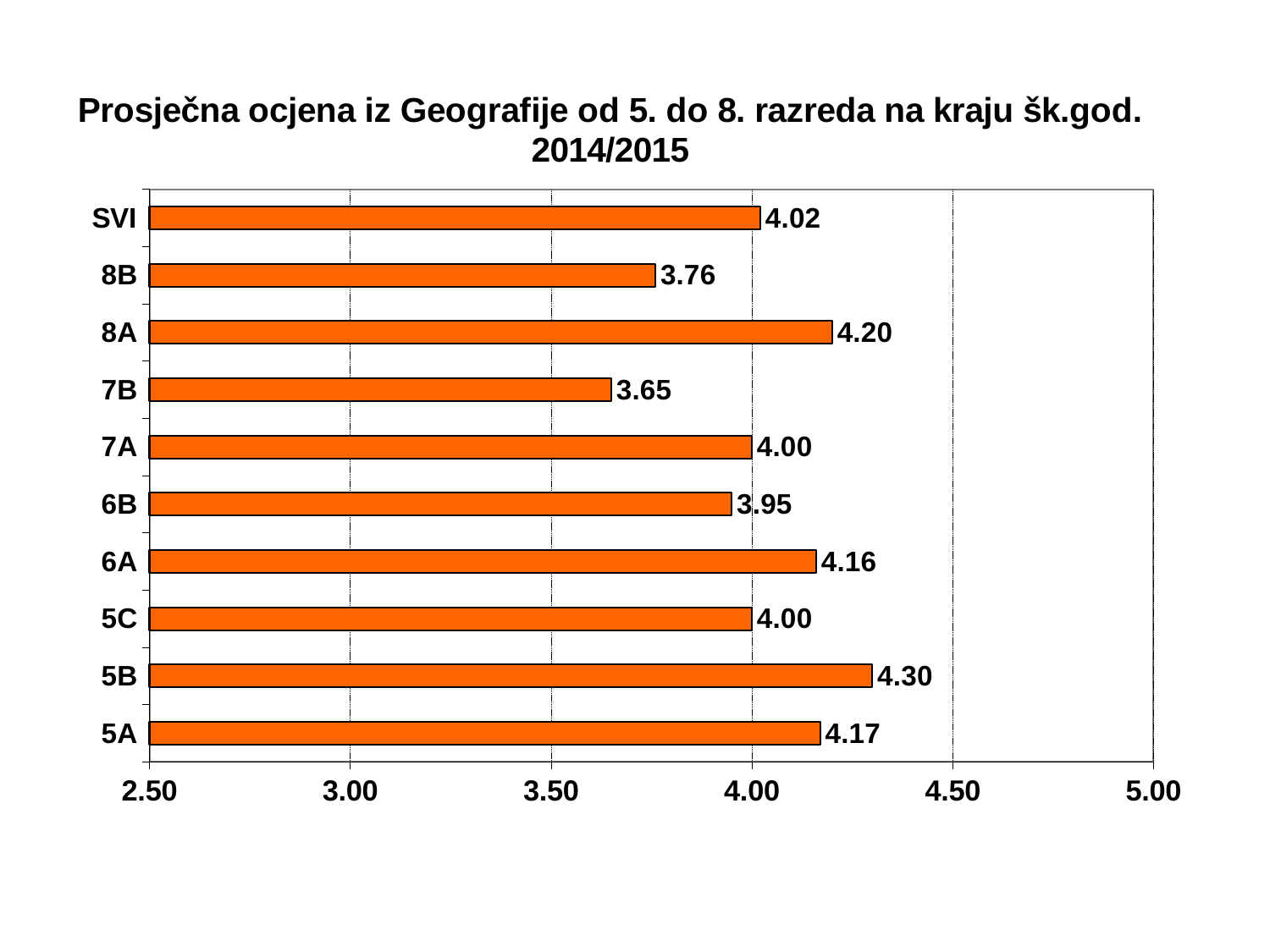
What type of chart is shown on the slide? bar chart What is the difference between the values for 8A and 8B? 0.44 What is the value shown for SVI? 4.02 What is the lowest value shown on the horizontal axis? 2.50 How many categories (bars) are shown in the chart? 10 Which class has the highest average grade? 5B Is the value for 8B greater or less than 4.00? less Which has a higher average grade, 6A or 6B? 6A What is the difference between the average grades of 5B and 7B? 0.65 What is the average Geography grade for class 5B? 4.30 What is the average grade for class 7B? 3.65 Which class has the lowest average grade? 7B